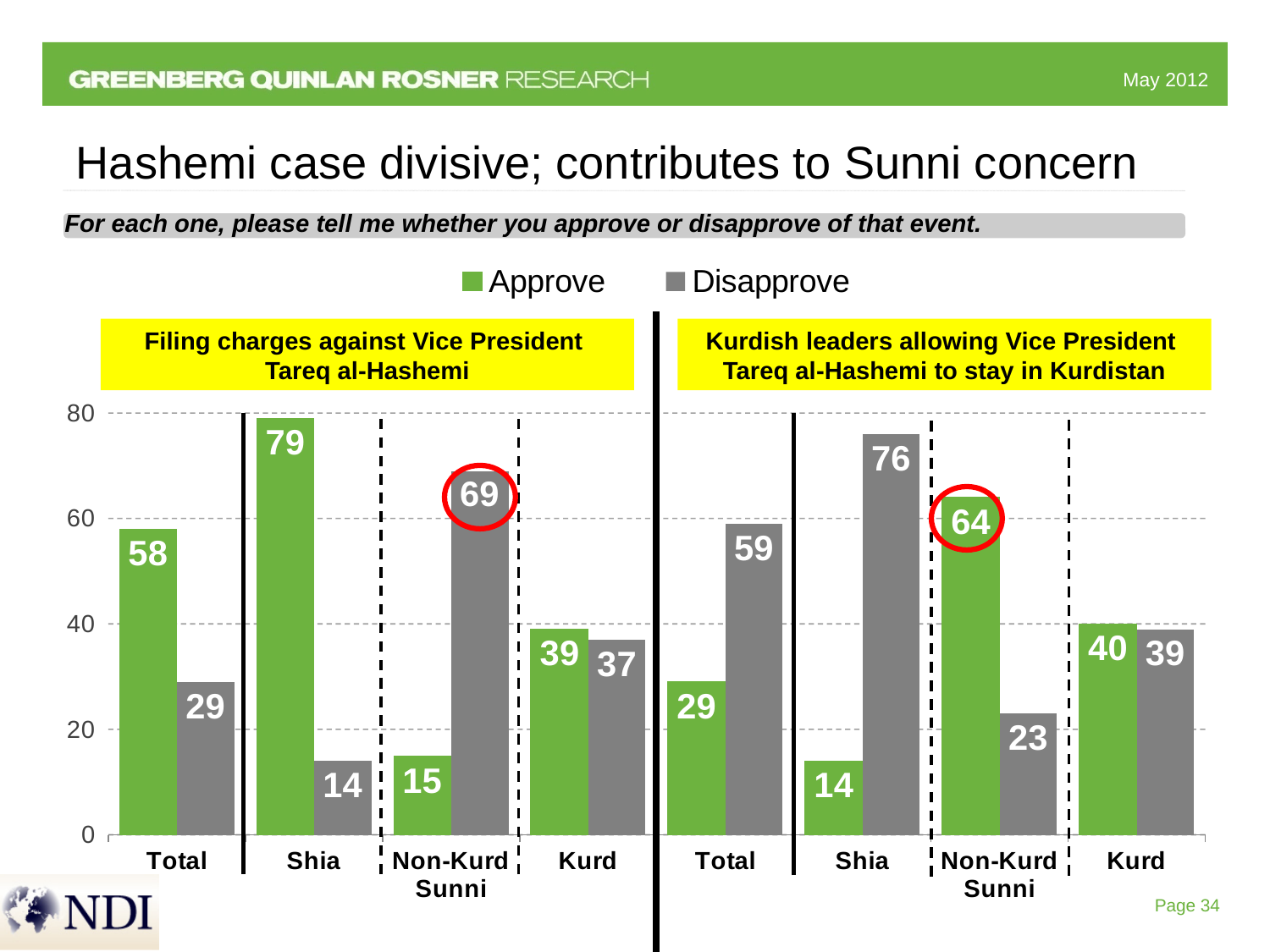
How many groups are shown on the x axis of each chart? 4 In the 'Filing charges against Vice President Tareq al-Hashemi' chart, is the Approve value for Non-Kurd Sunni larger or smaller than the Disapprove value? smaller In the 'Kurdish leaders allowing Vice President Tareq al-Hashemi to stay in Kurdistan' chart, which group has the lowest Approve value? Shia In the 'Kurdish leaders allowing Vice President Tareq al-Hashemi to stay in Kurdistan' chart, what is the Approve value for Non-Kurd Sunni? 64 In the 'Filing charges against Vice President Tareq al-Hashemi' chart, what is the Disapprove value for Non-Kurd Sunni? 69 In the 'Filing charges against Vice President Tareq al-Hashemi' chart, what is the difference between the Approve and Disapprove values for Total? 29 How many series does the legend list? 2 In the 'Filing charges against Vice President Tareq al-Hashemi' chart, which group has the highest Approve value? Shia In the 'Kurdish leaders allowing Vice President Tareq al-Hashemi to stay in Kurdistan' chart, what is the Disapprove value for Total? 59 In the 'Kurdish leaders allowing Vice President Tareq al-Hashemi to stay in Kurdistan' chart, what is the difference between the Disapprove and Approve values for Shia? 62 What type of chart is used on this slide? bar chart In the 'Filing charges against Vice President Tareq al-Hashemi' chart, what is the Approve value for Shia? 79